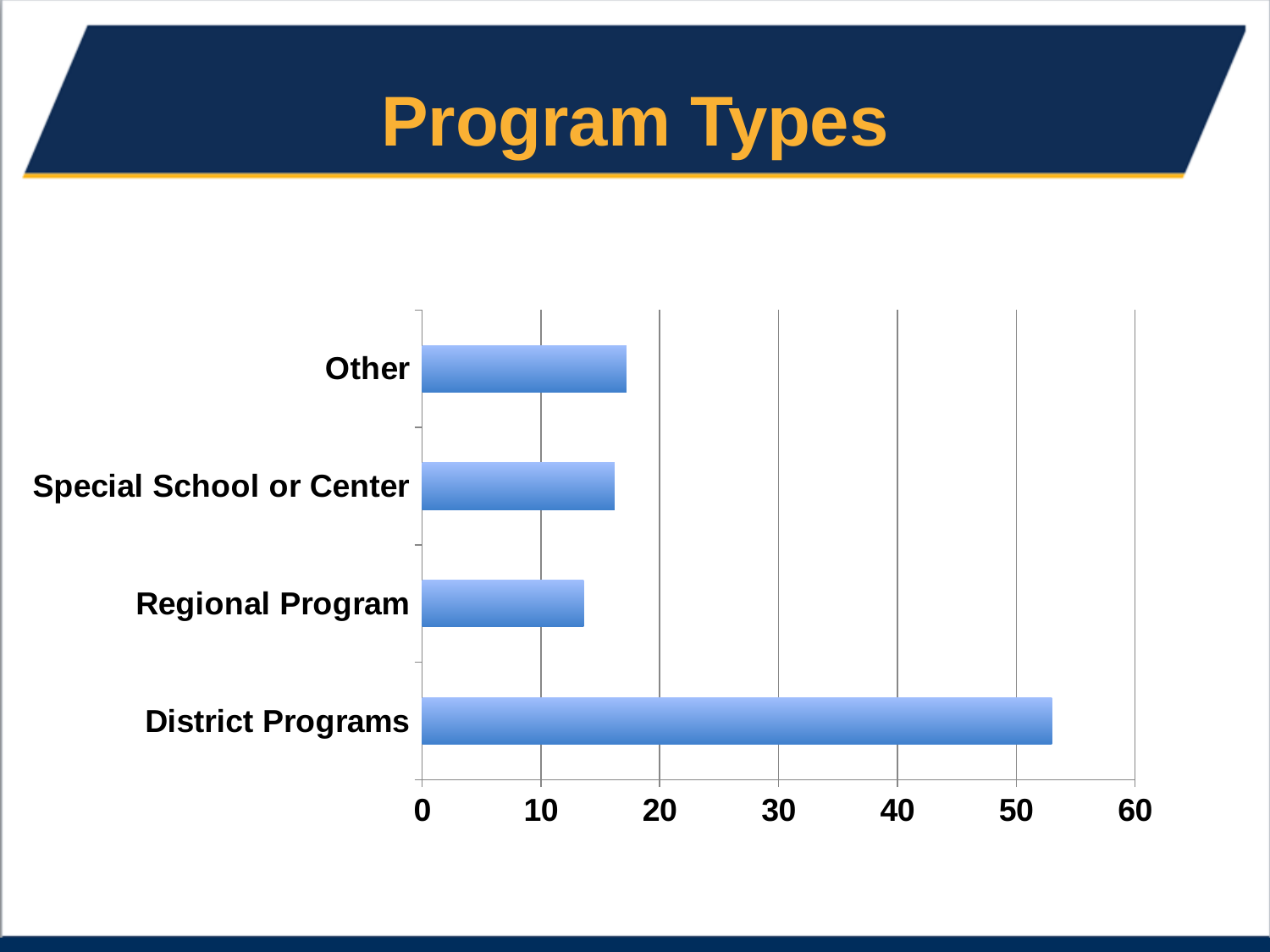
Which is larger, the value for District Programs or the value for Regional Program? District Programs What is the maximum value shown on the horizontal axis? 60 What kind of chart is shown on the slide? bar chart Is the value for Other greater or less than 20? less Is the value for Special School or Center greater or less than 10? greater What is the title of the slide containing the chart? Program Types Which category has the highest value? District Programs Is the value for Regional Program greater or less than 20? less Which is larger, the value for Other or the value for District Programs? District Programs How many categories are shown in the chart? 4